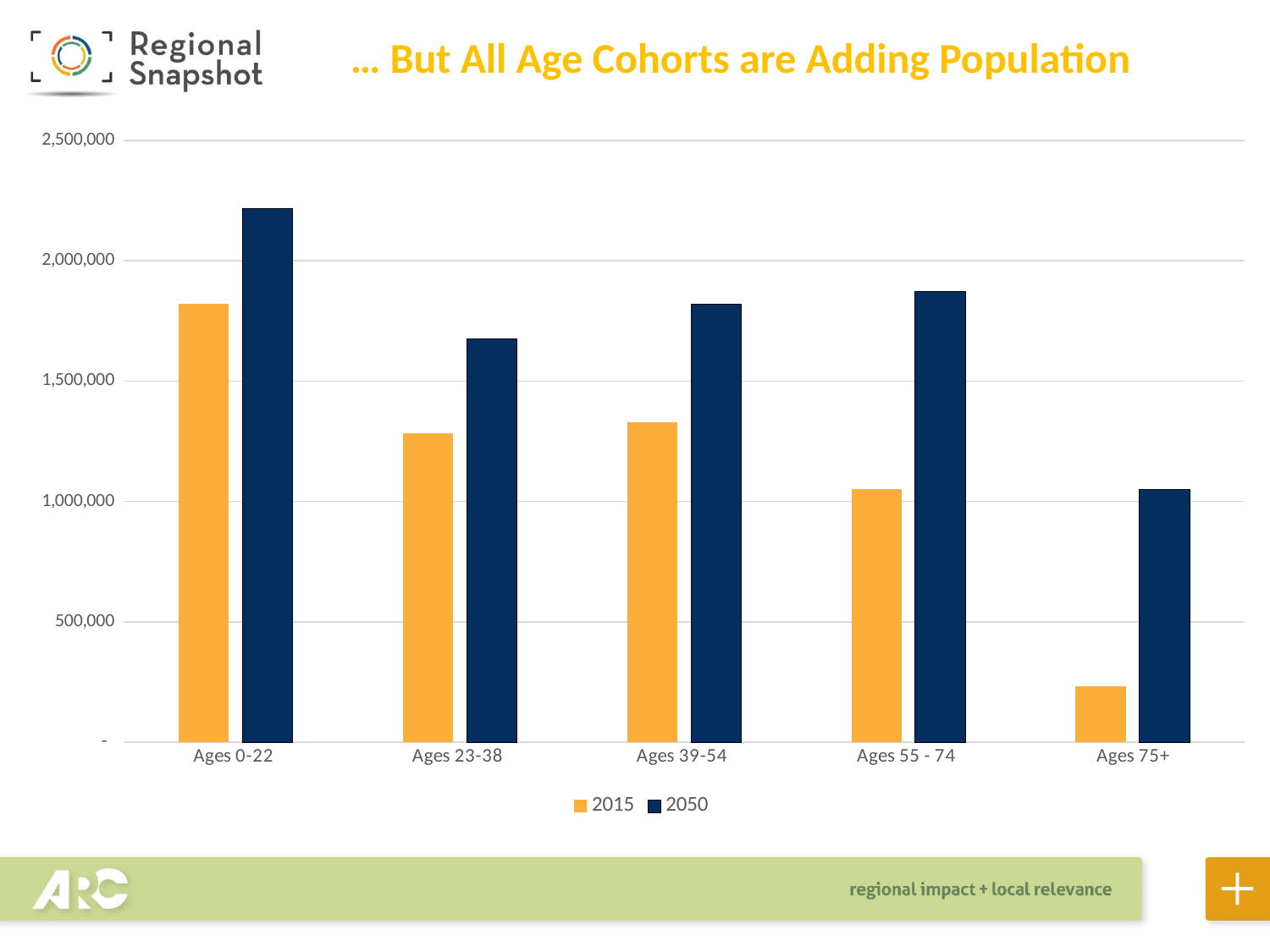
Is the 2050 value for Ages 55 - 74 greater or less than 1,500,000? greater How many series does the legend list? 2 Is the 2050 value for Ages 0-22 greater or less than 2,000,000? greater Which age cohort has the lowest 2050 value? Ages 75+ Which is larger, the 2015 value for Ages 0-22 or the 2015 value for Ages 23-38? Ages 0-22 How many age cohorts are shown on the x axis? 5 Which age cohort has the lowest 2015 value? Ages 75+ Which colour represents the 2050 series in the chart? dark blue Is the 2015 value for Ages 23-38 greater or less than 1,500,000? less Which age cohort has the highest 2050 value? Ages 0-22 What kind of chart is shown on the slide? bar chart